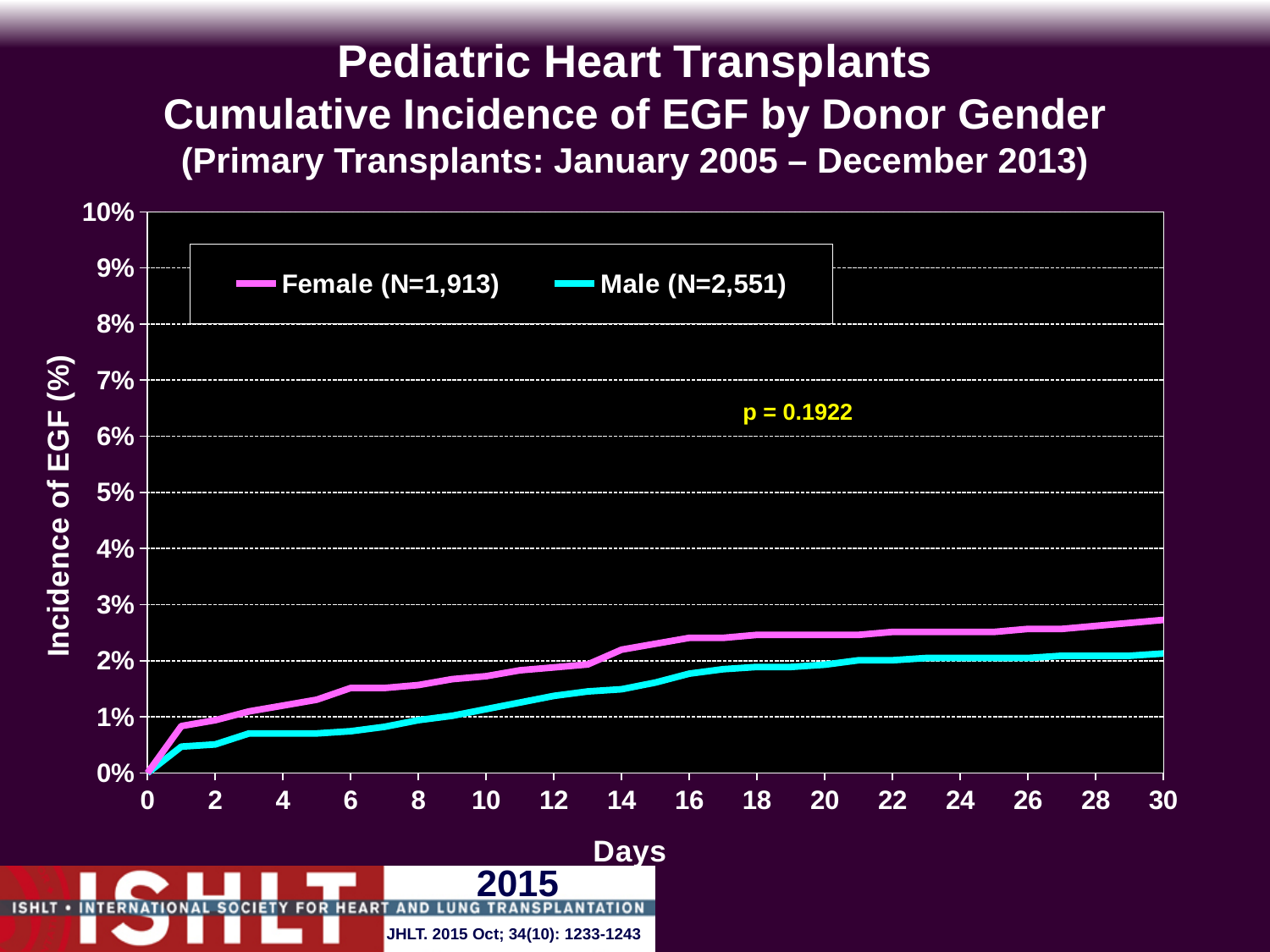
What p-value is printed on the chart? p = 0.1922 Is the value for the Female series at day 30 greater or less than 2%? greater Which series has the higher cumulative incidence of EGF at day 30, Female or Male? Female What is the N shown in the legend for the Male series? N=2,551 Is the value for the Male series at day 30 greater or less than 3%? less Is the value for the Female series at day 16 greater or less than 2%? greater How many series does the legend list? 2 What kind of chart is shown on the slide? line chart Do the values for the Female series rise or fall as the number of days increases? rise How many tick labels are shown on the x axis (Days)? 16